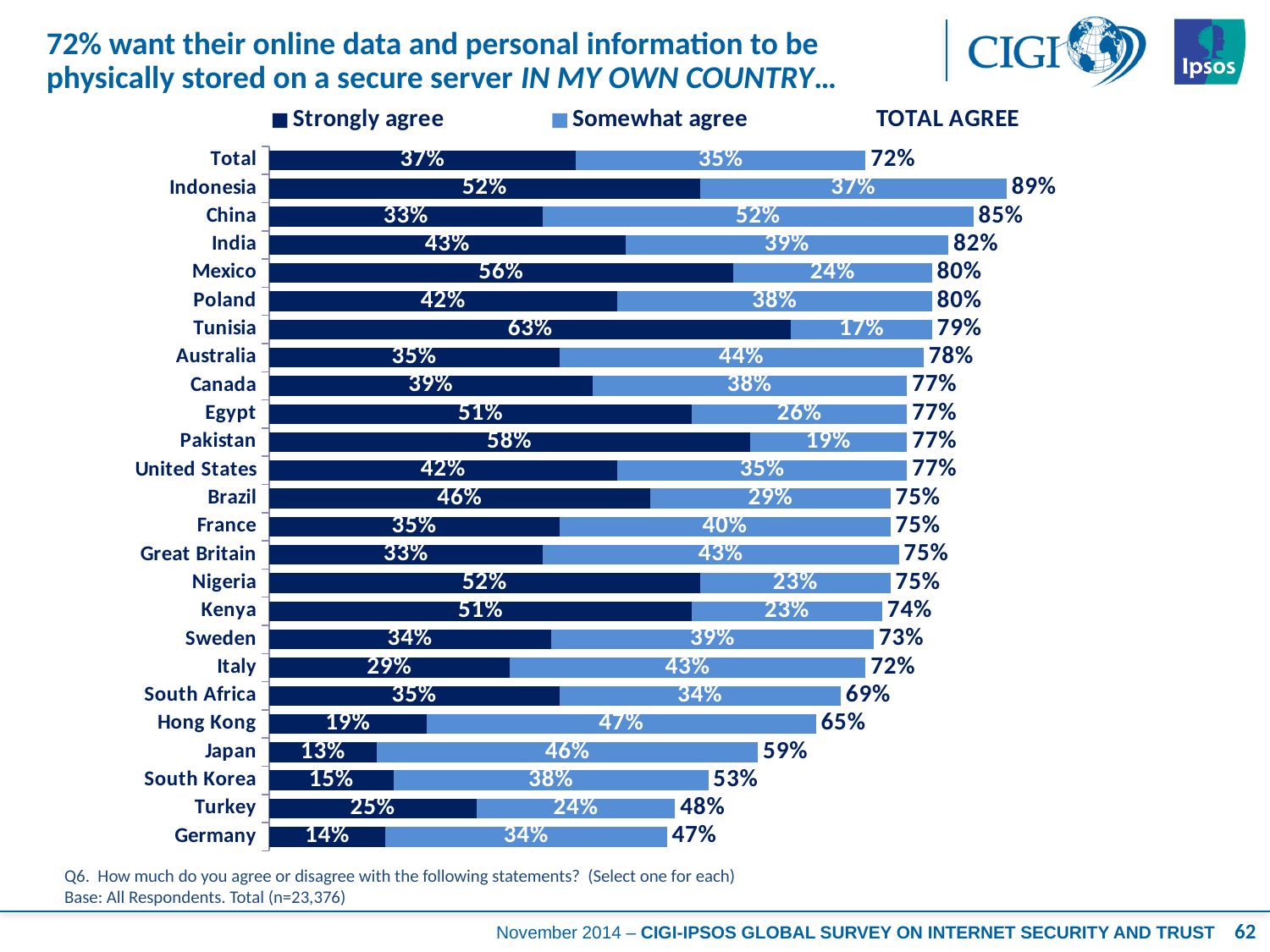
How many series does the legend list? 2 What is the total of the stacked bar for Hong Kong? 65% Which country has the highest Strongly agree value? Tunisia What percentage of respondents in Indonesia strongly agree? 52% What is the TOTAL AGREE value for Germany? 47% Which has a larger Strongly agree value, Mexico or Poland? Mexico Which country has the lowest TOTAL AGREE value? Germany What is the difference between the TOTAL AGREE values for Indonesia and Japan? 30% How many countries or categories are listed on the chart? 25 What is the Somewhat agree value for China? 52% What kind of chart is shown on the slide? Stacked bar chart What are the two series named in the legend? Strongly agree and Somewhat agree